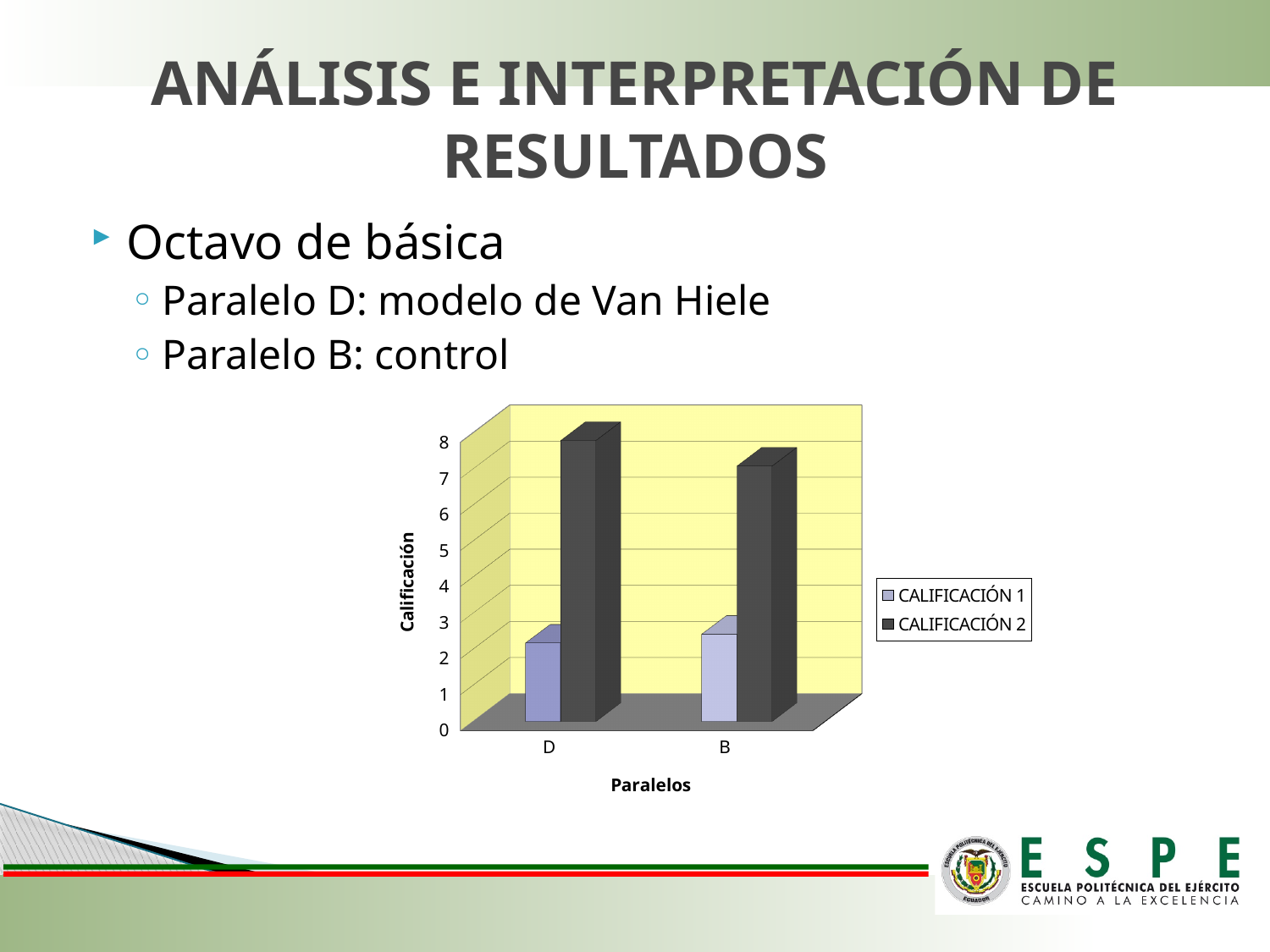
What kind of chart is shown on the slide? bar chart What is the title of the chart's horizontal axis? Paralelos Is the CALIFICACIÓN 1 value for paralelo D greater or less than 4? less Is the CALIFICACIÓN 2 value for paralelo B greater or less than 5? greater What is the title of the chart's vertical axis? Calificación How many series does the chart's legend list? 2 Is the CALIFICACIÓN 1 value for paralelo B greater or less than 4? less How many categories (paralelos) are shown on the x axis of the chart? 2 Which paralelo has the higher CALIFICACIÓN 2 bar, D or B? D Which paralelo has the highest CALIFICACIÓN 2 value? D For paralelo B, which series has the larger bar, CALIFICACIÓN 1 or CALIFICACIÓN 2? CALIFICACIÓN 2